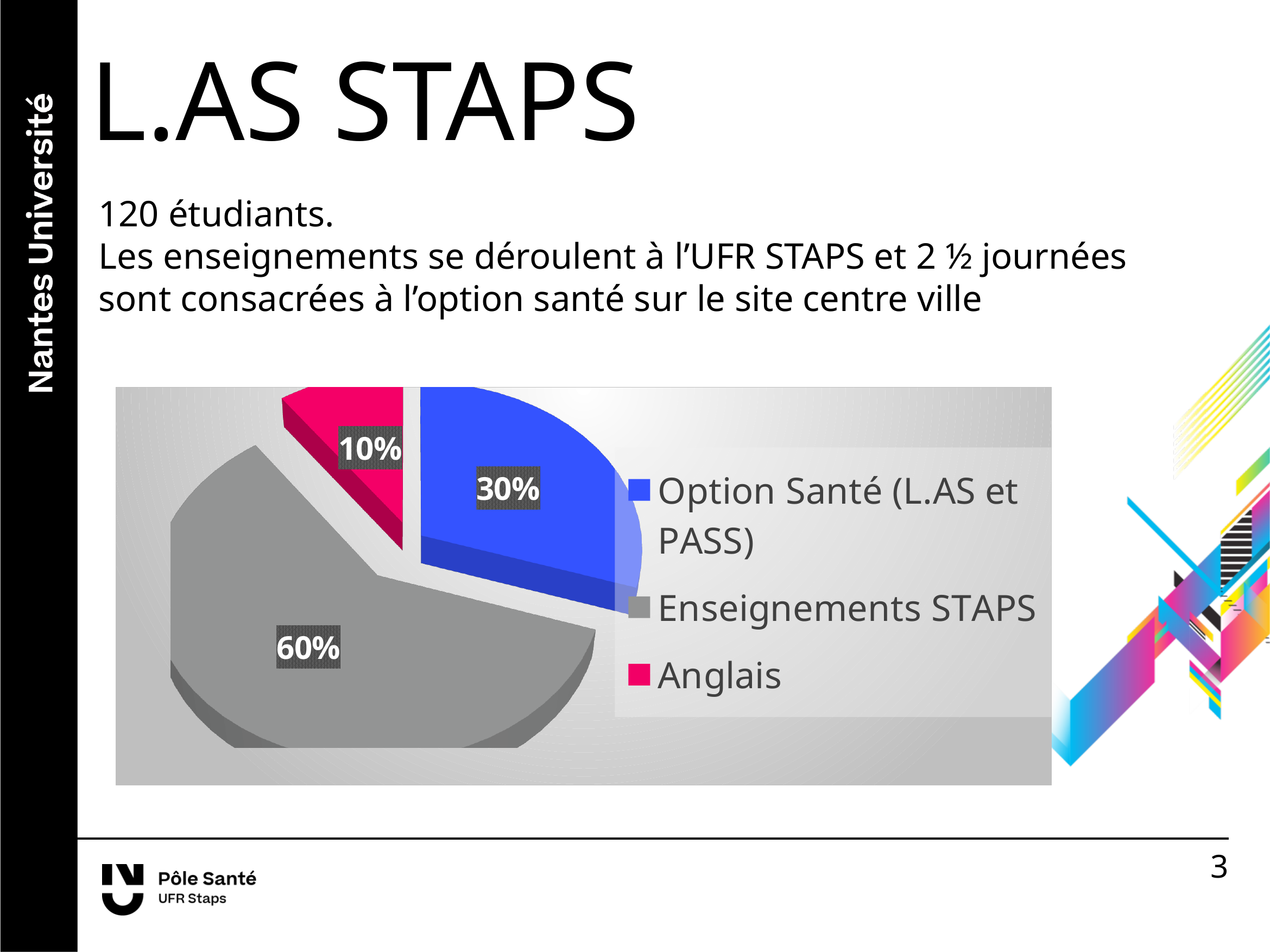
What share of the pie does Enseignements STAPS represent? 60% How many categories does the pie chart have? 3 What share of the pie does Option Santé (L.AS et PASS) represent? 30% What colour is the slice for Anglais? Pink Which is larger, the slice for Option Santé (L.AS et PASS) or the slice for Anglais? Option Santé (L.AS et PASS) What kind of chart is shown on the slide? Pie chart What is the difference in percentage points between Enseignements STAPS and Option Santé (L.AS et PASS)? 30% What is the difference in percentage points between Option Santé (L.AS et PASS) and Anglais? 20% How many entries does the legend list? 3 Which category has the largest slice of the pie? Enseignements STAPS What share of the pie does Anglais represent? 10% Which category has the smallest slice of the pie? Anglais